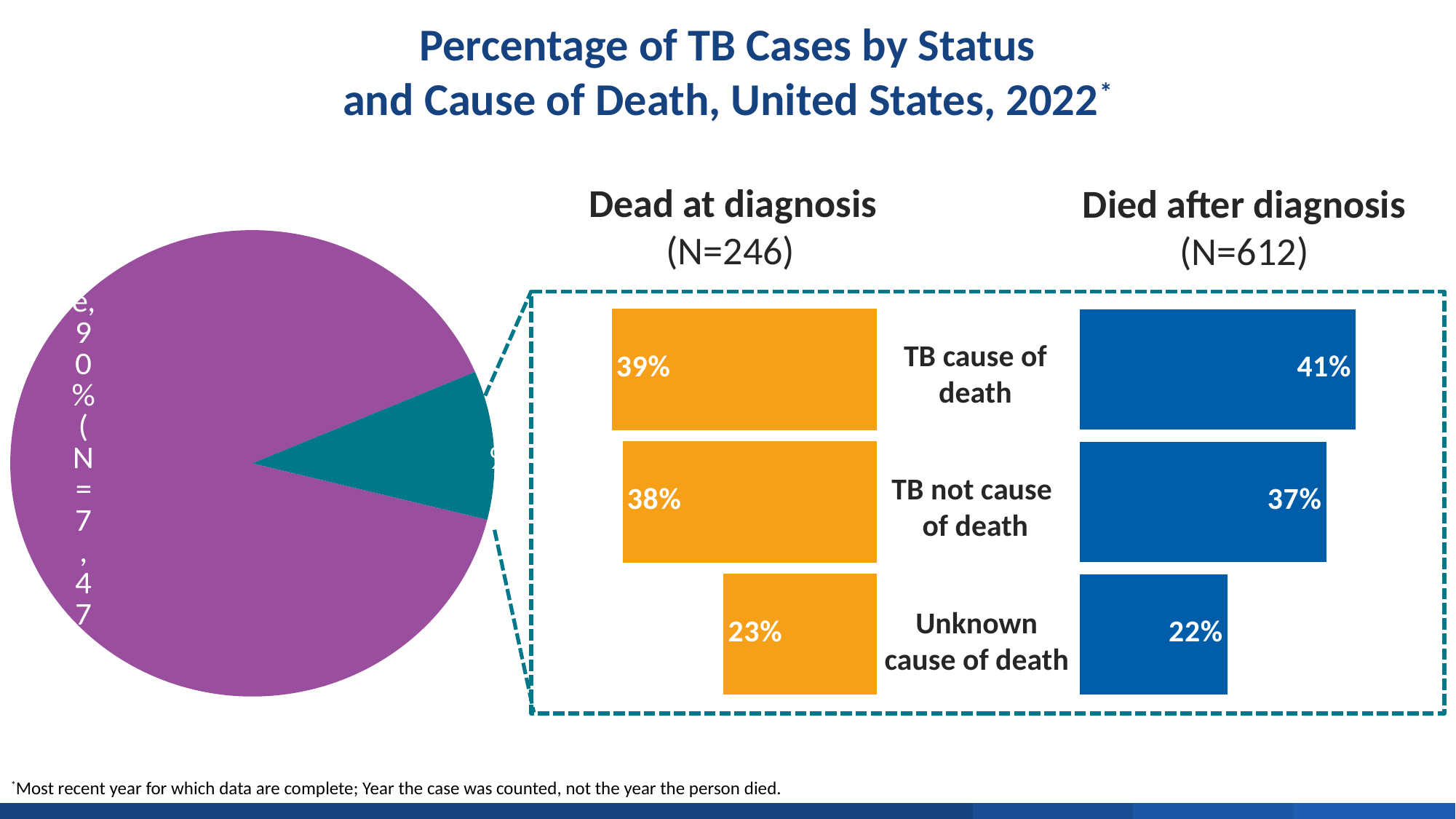
In the 'Dead at diagnosis' chart, which cause-of-death category has the lowest percentage? Unknown cause of death In the 'Dead at diagnosis' chart, what percentage is shown for 'TB cause of death'? 39% What kind of chart is the 'Dead at diagnosis' chart? Bar chart How many cause-of-death categories are shown in the 'Dead at diagnosis' chart? 3 For 'Unknown cause of death', which group has the larger percentage: 'Dead at diagnosis' or 'Died after diagnosis'? Dead at diagnosis In the 'Died after diagnosis' chart, what is the difference in percentage points between 'TB cause of death' and 'Unknown cause of death'? 19 percentage points What is the N value given for the 'Died after diagnosis' group? 612 In the 'Died after diagnosis' chart, what percentage is shown for 'TB cause of death'? 41% What kind of chart is shown on the left side of the slide? Pie chart In the 'Dead at diagnosis' chart, what percentage is shown for 'Unknown cause of death'? 23% In the 'Died after diagnosis' chart, which cause-of-death category has the highest percentage? TB cause of death In the 'Died after diagnosis' chart, what percentage is shown for 'TB not cause of death'? 37%